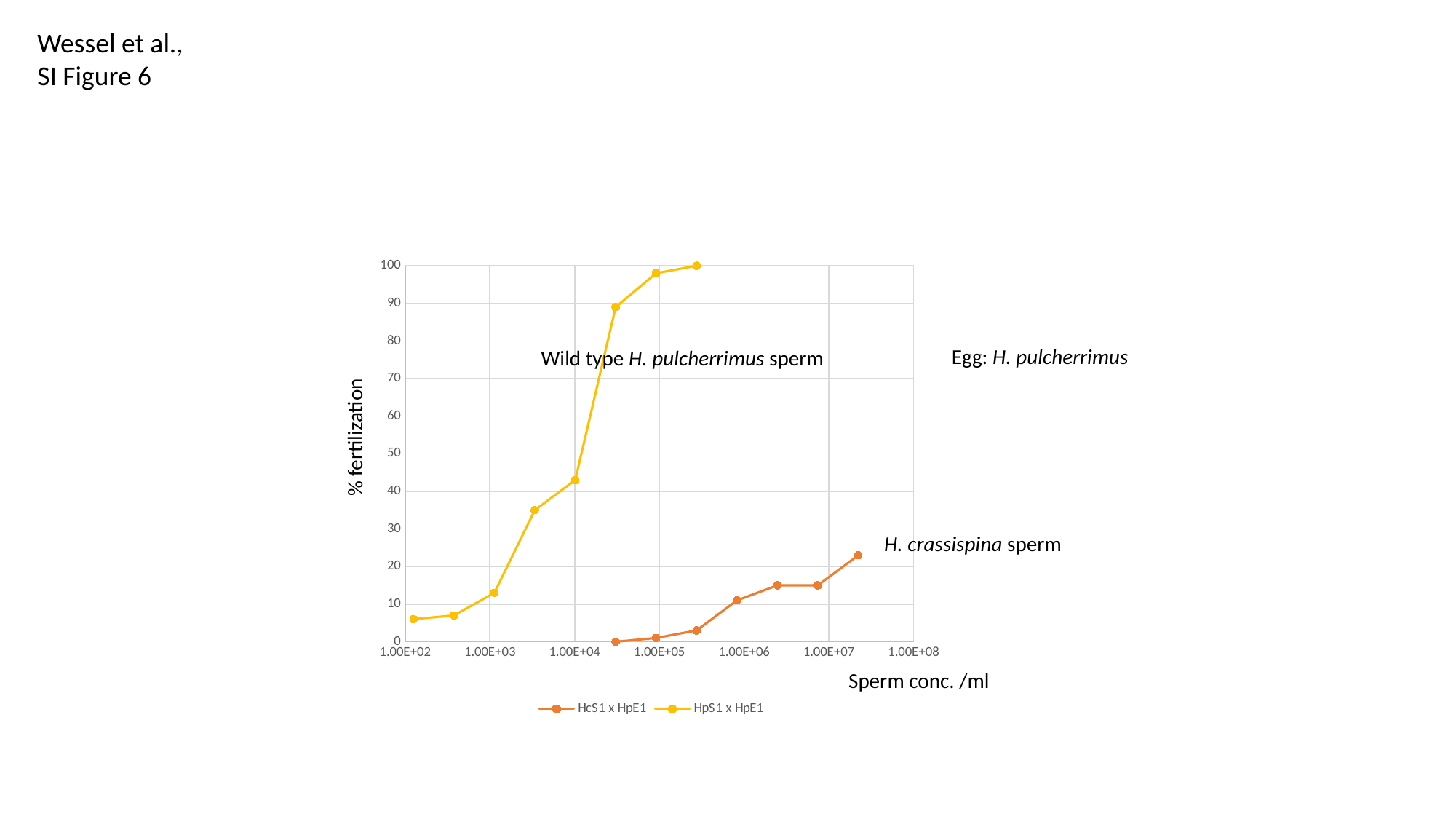
What kind of chart is shown on the slide? line chart Is the % fertilization for HcS1 x HpE1 at a sperm concentration of 1.00E+05 greater or less than 10? less What is the highest % fertilization reached by the HpS1 x HpE1 series? 100 How many series does the legend list? 2 Is the % fertilization for HpS1 x HpE1 at a sperm concentration of 1.00E+04 greater or less than 40? greater How many data points are plotted for the HcS1 x HpE1 series? 7 What is the label of the y axis? % fertilization What are the two series named in the legend? HcS1 x HpE1 and HpS1 x HpE1 Which series reaches the higher % fertilization, HcS1 x HpE1 or HpS1 x HpE1? HpS1 x HpE1 Is the highest % fertilization reached by the HcS1 x HpE1 series greater or less than 20? greater How many data points are plotted for the HpS1 x HpE1 series? 8 Does the % fertilization for the HpS1 x HpE1 series rise or fall as sperm concentration increases? rise